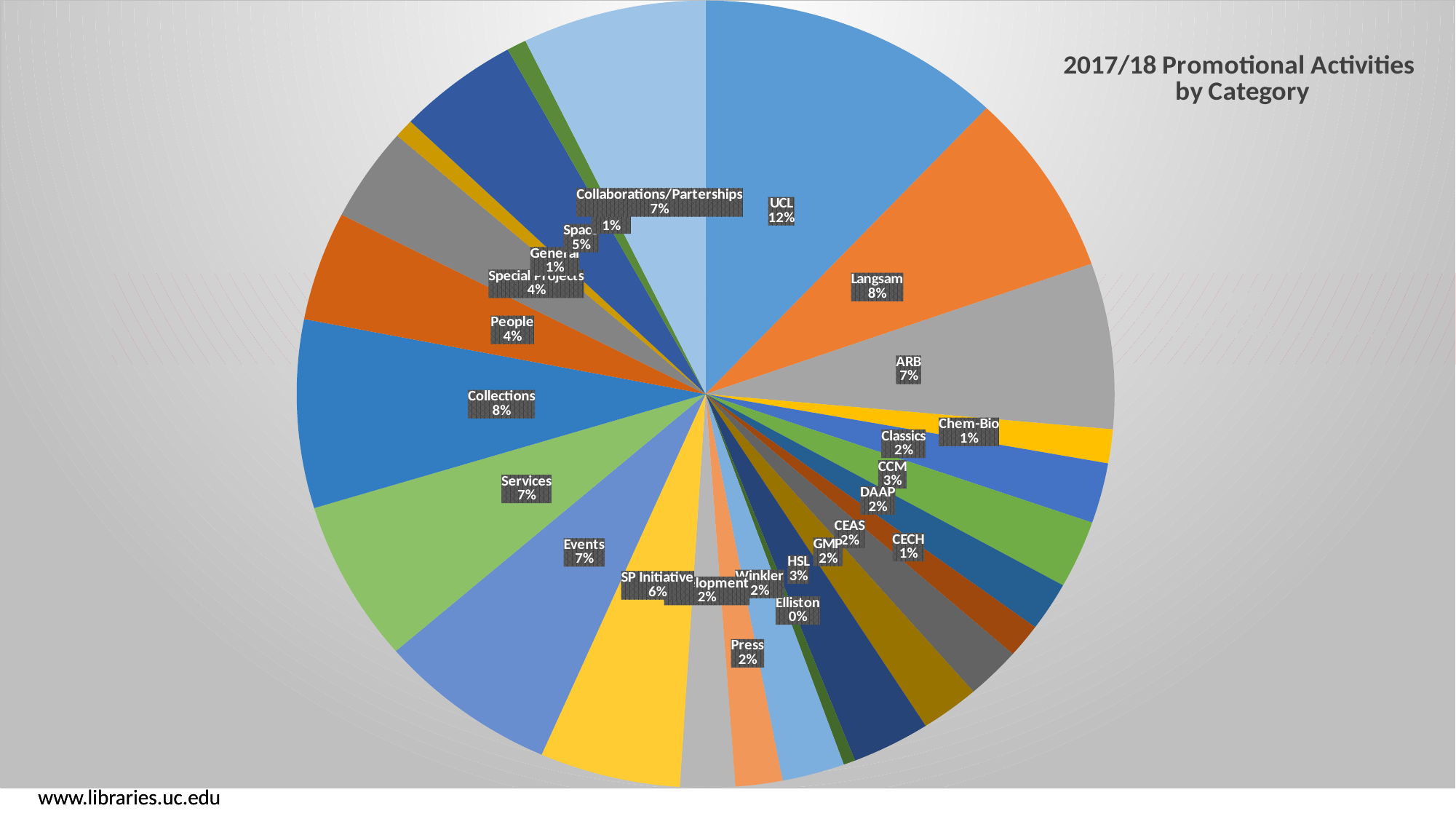
Which category has the largest share of the pie? UCL What is the difference in percentage points between UCL and Langsam? 4 What type of chart is shown on the slide? pie chart What percentage is shown for Langsam? 8% What share of promotional activities does UCL account for? 12% Which category has the smallest share, at 0%? Elliston What percentage is shown for Collaborations/Partnerships? 7% What percentage is shown for SP Initiative? 6% What percentage is shown for HSL? 3% What is the title of the chart? 2017/18 Promotional Activities by Category What percentage is shown for Collections? 8% Which has a larger share, Events or People? Events